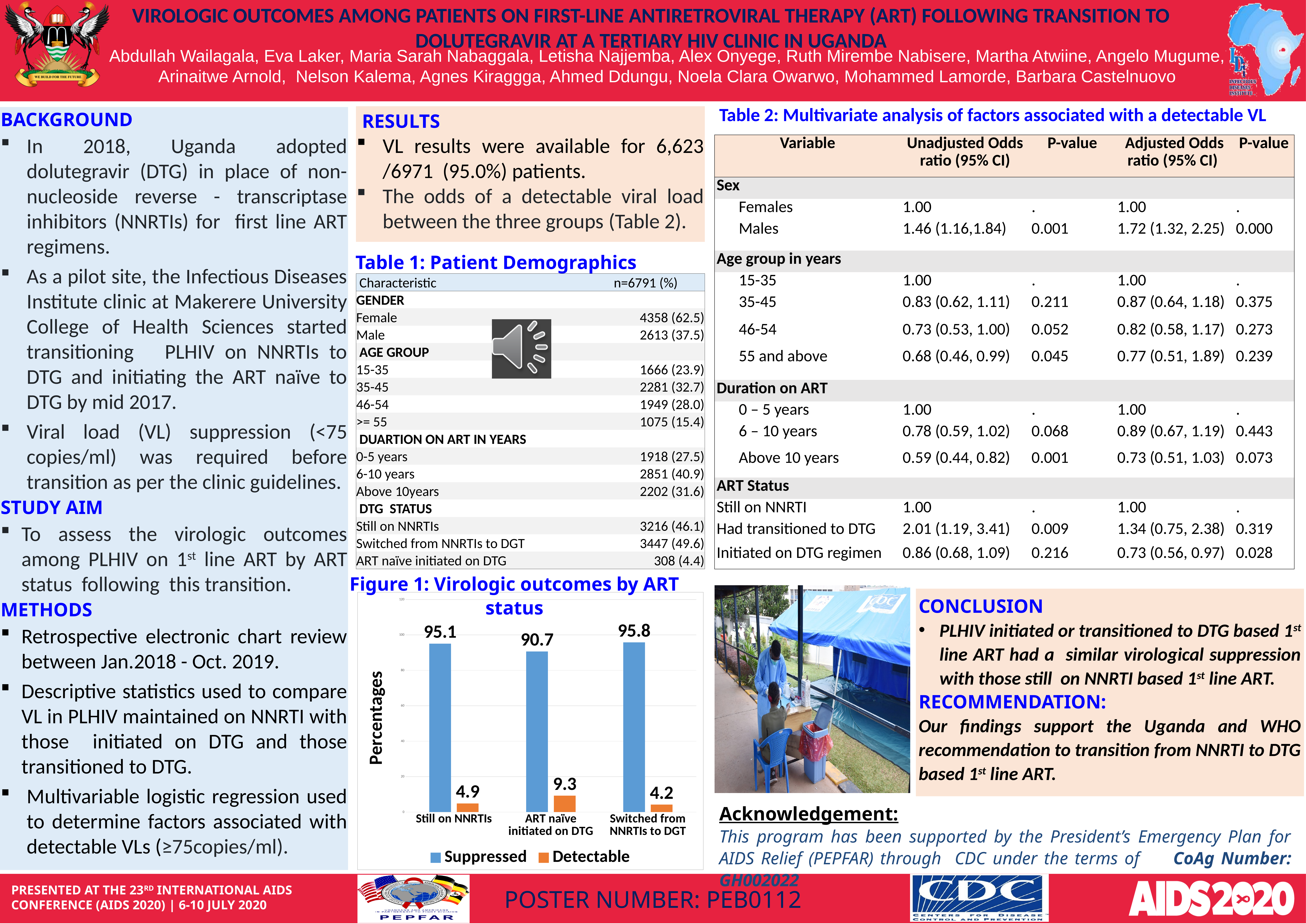
In Figure 1, what is the Suppressed value for Switched from NNRTIs to DGT? 95.8 In Figure 1, is the Suppressed value for Still on NNRTIs larger or the Suppressed value for ART naïve initiated on DTG? Still on NNRTIs In Figure 1, what is the Detectable value for Switched from NNRTIs to DGT? 4.2 In Figure 1, which ART status group has the lowest Suppressed value? ART naïve initiated on DTG In Figure 1, which ART status group has the highest Suppressed value? Switched from NNRTIs to DGT In Figure 1, what is the Suppressed value for Still on NNRTIs? 95.1 What type of chart is Figure 1: Virologic outcomes by ART status? bar chart How many series does the legend of Figure 1 list? 2 How many ART status categories are shown on the x axis of Figure 1? 3 In Figure 1, which ART status group has the highest Detectable value? ART naïve initiated on DTG In Figure 1, what is the difference between the Detectable values for ART naïve initiated on DTG and Still on NNRTIs? 4.4 In Figure 1, what is the Detectable value for ART naïve initiated on DTG? 9.3